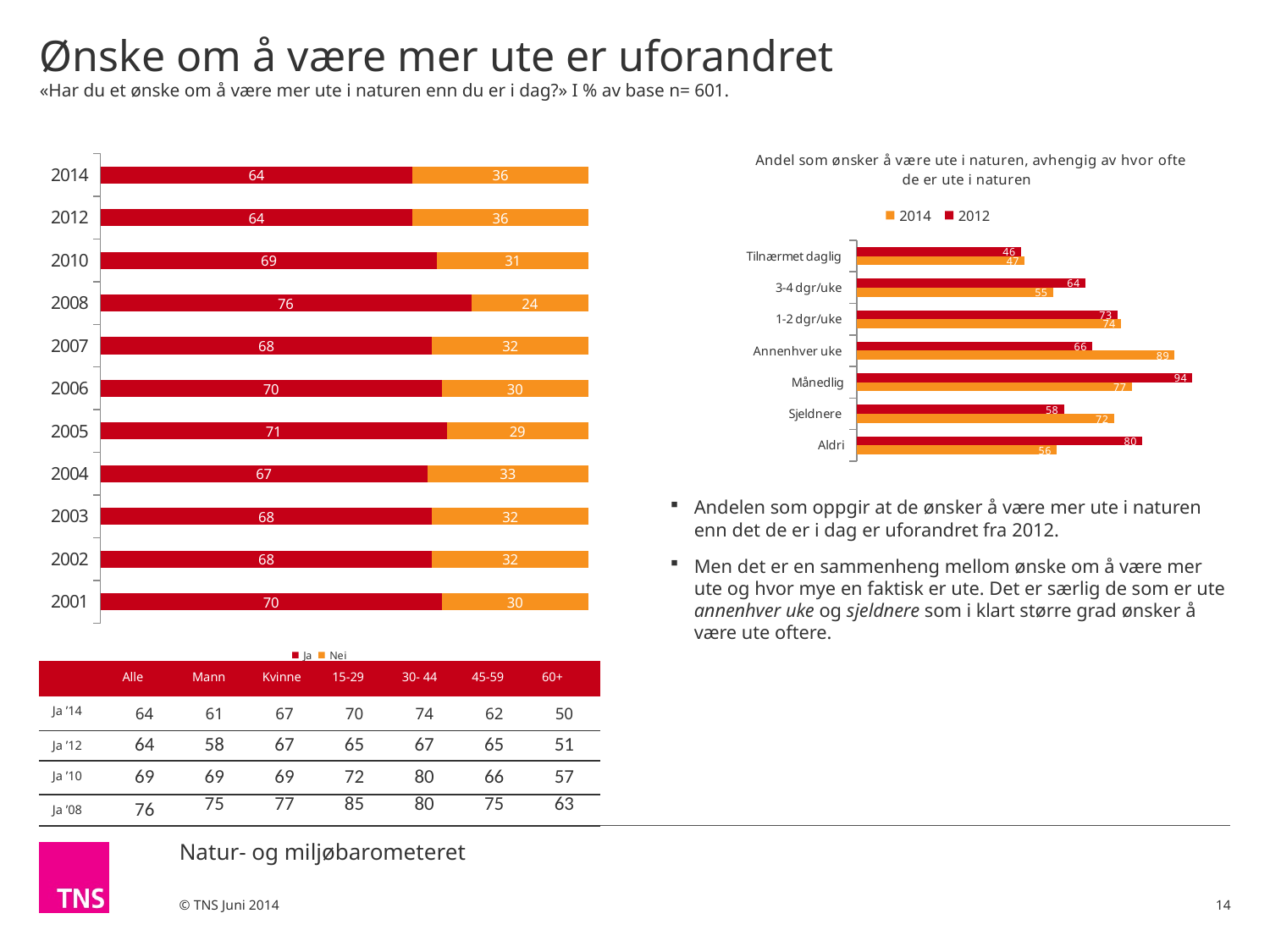
In the chart 'Andel som ønsker å være ute i naturen, avhengig av hvor ofte de er ute i naturen', which is larger for 'Aldri': the 2014 value or the 2012 value? 2012 In the left chart, how many years are shown? 11 In the chart 'Andel som ønsker å være ute i naturen, avhengig av hvor ofte de er ute i naturen', what is the 2014 value for 'Annenhver uke'? 89 What type of chart is the left chart? Stacked bar chart In the chart 'Andel som ønsker å være ute i naturen, avhengig av hvor ofte de er ute i naturen', what is the 2012 value for 'Månedlig'? 94 In the left chart, what is the total of the stacked bar for 2005? 100 In the left chart, what is the difference between the 'Ja' values for 2008 and 2014? 12 In the left chart, what is the 'Nei' value for 2010? 31 In the left chart, which year has the highest 'Ja' value? 2008 In the left chart, what is the 'Ja' value for 2008? 76 In the chart 'Andel som ønsker å være ute i naturen, avhengig av hvor ofte de er ute i naturen', which category has the lowest 2014 value? Tilnærmet daglig How many series does the legend of the chart 'Andel som ønsker å være ute i naturen, avhengig av hvor ofte de er ute i naturen' list? 2